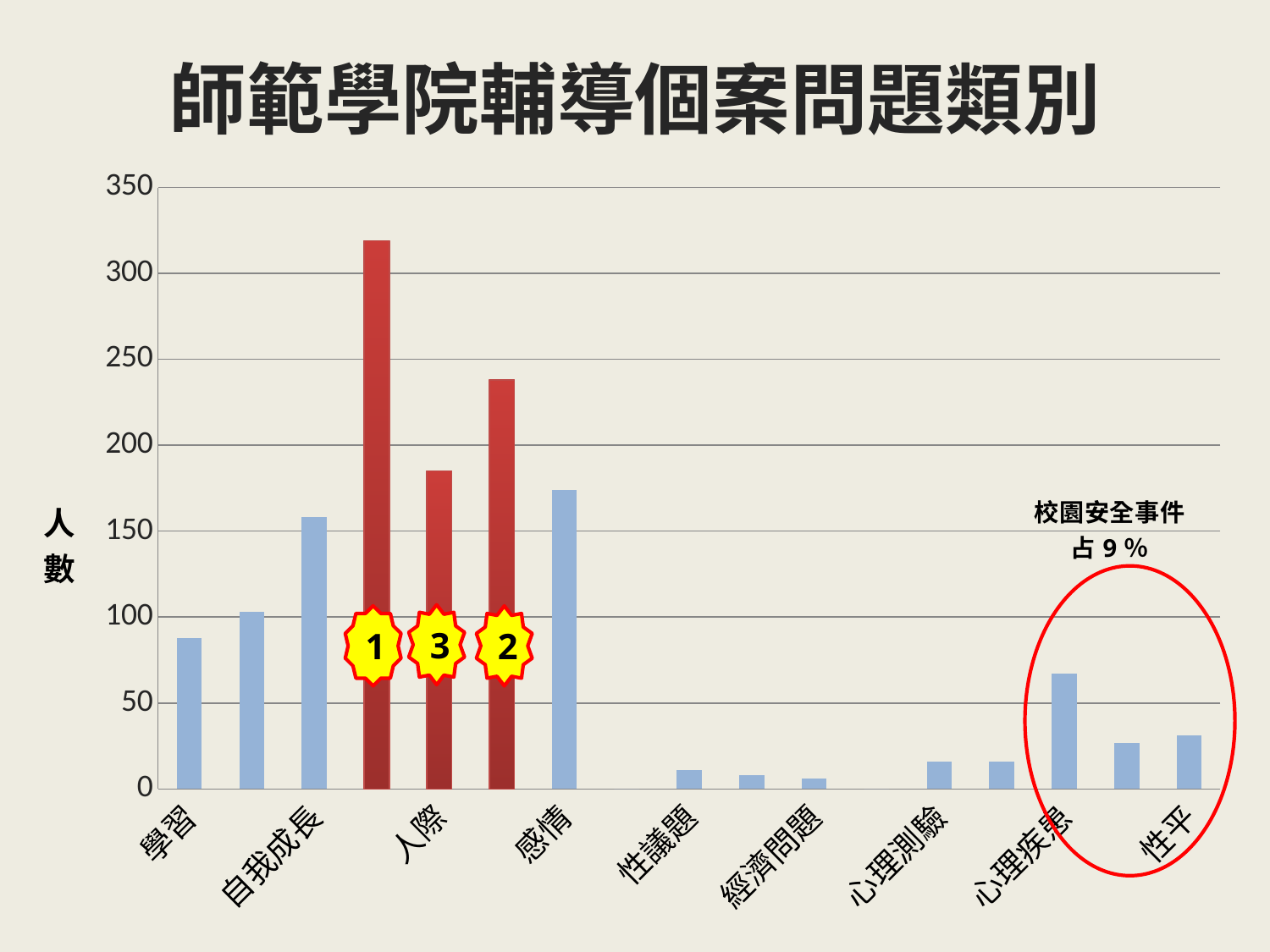
Is the value for 性平 greater or less than 50? less What is the title of the chart? 師範學院輔導個案問題類別 Is the value for 學習 greater or less than 100? less Is the value for 心理疾患 greater or less than 50? greater What kind of chart is shown on the slide? bar chart Which has a larger value, 自我成長 or 經濟問題? 自我成長 Which has a larger value, 人際 or 學習? 人際 Which has a larger value, 心理疾患 or 性平? 心理疾患 What is the label on the vertical axis of the chart? 人數